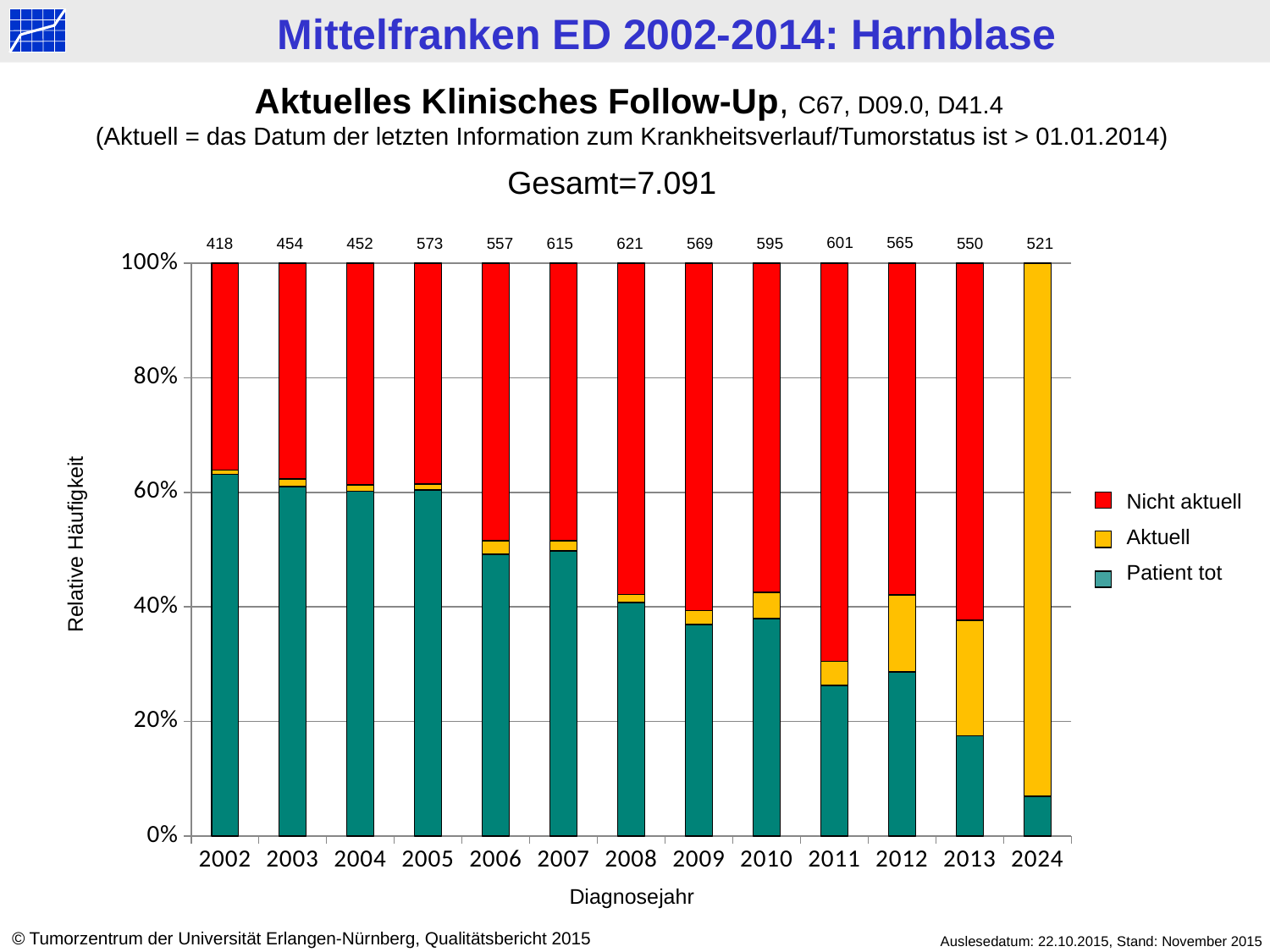
Is the 'Patient tot' share for 2013 greater or less than 20%? less What number is printed above the bar for 2002? 418 Which has the larger number printed above its bar, 2005 or 2006? 2005 What is the difference between the numbers printed above the bars for 2008 and 2002? 203 How many series does the legend list? 3 Is the 'Patient tot' share for 2002 greater or less than 60%? greater Which diagnosis year has the highest number printed above its bar? 2008 How many diagnosis years are shown on the x axis? 13 What kind of chart is shown on the slide? Stacked bar chart What number is printed above the bar for the last category, 2024? 521 What number is printed above the bar for 2011? 601 Which diagnosis year has the lowest number printed above its bar? 2002